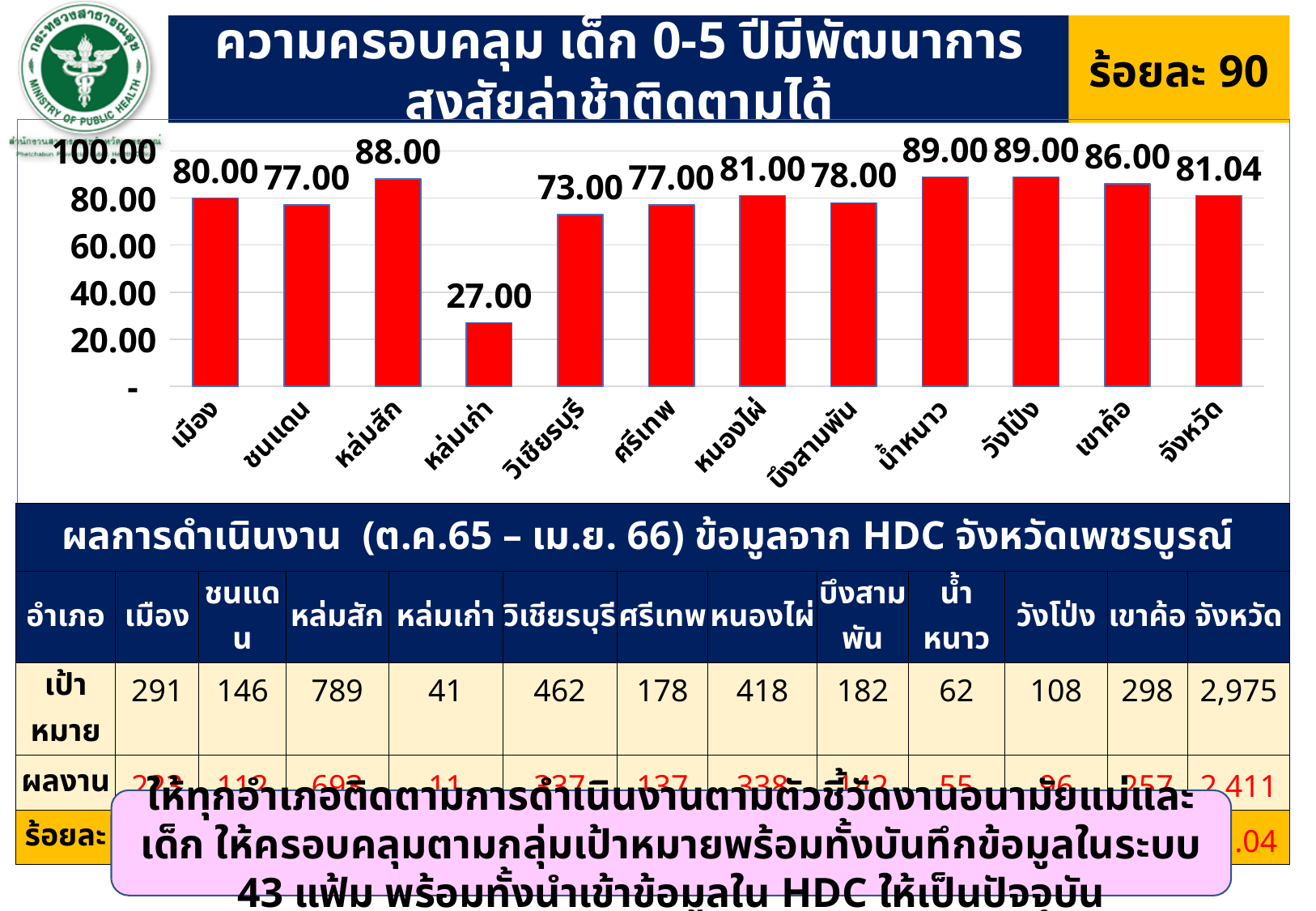
What kind of chart is shown? bar chart What is the value for หล่มเก่า? 27.00 What is the value for หล่มสัก? 88.00 Which category has the lowest value? หล่มเก่า What is the value for วิเชียรบุรี? 73.00 What colour are the bars in the chart? red What is the difference between the values for น้ำหนาว and เขาค้อ? 3.00 Is the value for หล่มเก่า greater or less than 40.00? less What is the difference between the values for หล่มสัก and หล่มเก่า? 61.00 How many categories are shown on the x axis? 12 What is the value for จังหวัด? 81.04 Which is larger, the value for เมือง or the value for บึงสามพัน? เมือง